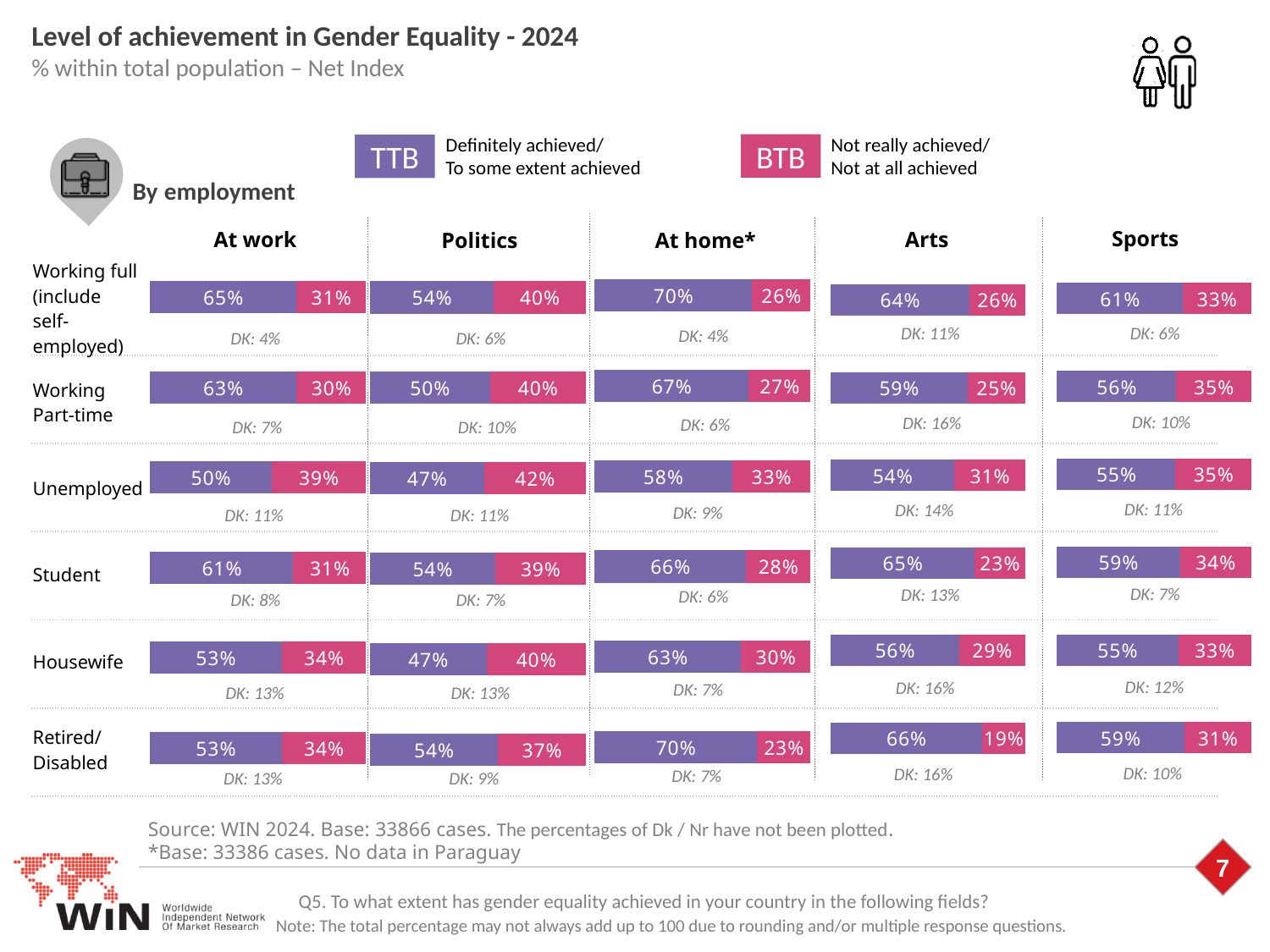
In the Sports chart, which has the larger TTB value: Working Part-time or Student? Student How many employment categories are shown in each chart? 6 What kind of chart is used to show the values on this slide? Stacked bar chart In the Arts chart, what is the DK value for Housewife? DK: 16% In the At work chart, what is the difference between the TTB and BTB values for Working full (include self-employed)? 34 percentage points How many series does the legend list? 2 In the Arts chart, which employment group has the lowest BTB value? Retired/Disabled In the At work chart, what is the TTB value for Working full (include self-employed)? 65% In the At home* chart, which employment group has the highest BTB value? Unemployed In the Politics chart, what is the BTB value for Unemployed? 42% In the At work chart, what is the total of the TTB and BTB segments for Unemployed? 89% In the At work chart, which employment group has the lowest TTB value? Unemployed